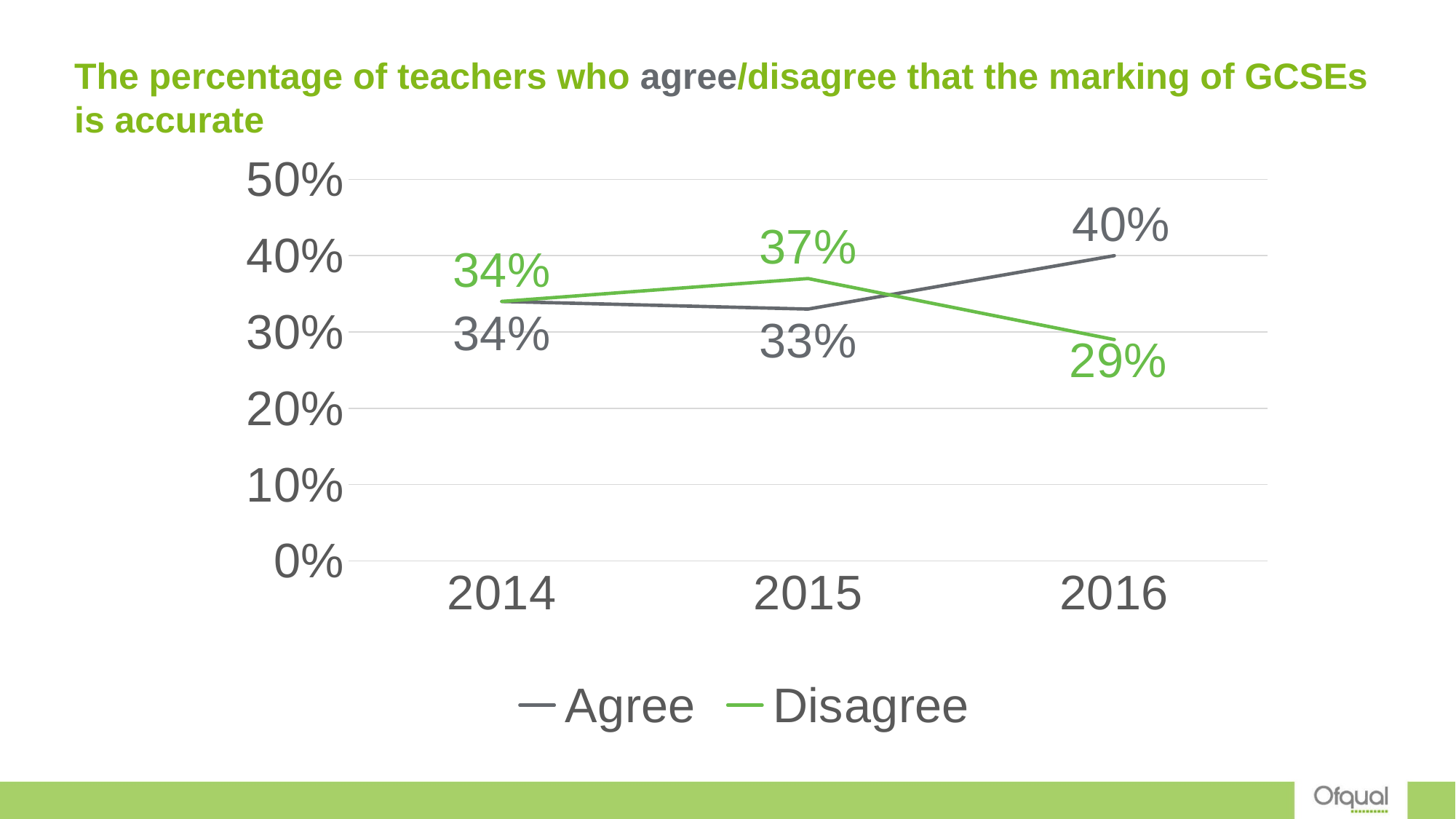
In which year is the Disagree percentage lowest? 2016 How many series does the legend list? 2 How many years are shown on the x axis? 3 What percentage of teachers disagreed that the marking of GCSEs is accurate in 2015? 37% What is the difference between the Agree and Disagree percentages in 2016? 11% What is the Agree value for 2014? 34% In which year is the Agree percentage highest? 2016 Does the Disagree line rise or fall between 2015 and 2016? Fall In 2015, which is larger: the Agree percentage or the Disagree percentage? Disagree What percentage of teachers agreed that the marking of GCSEs is accurate in 2016? 40% What is the Disagree value for 2016? 29% What kind of chart is shown on the slide? Line chart